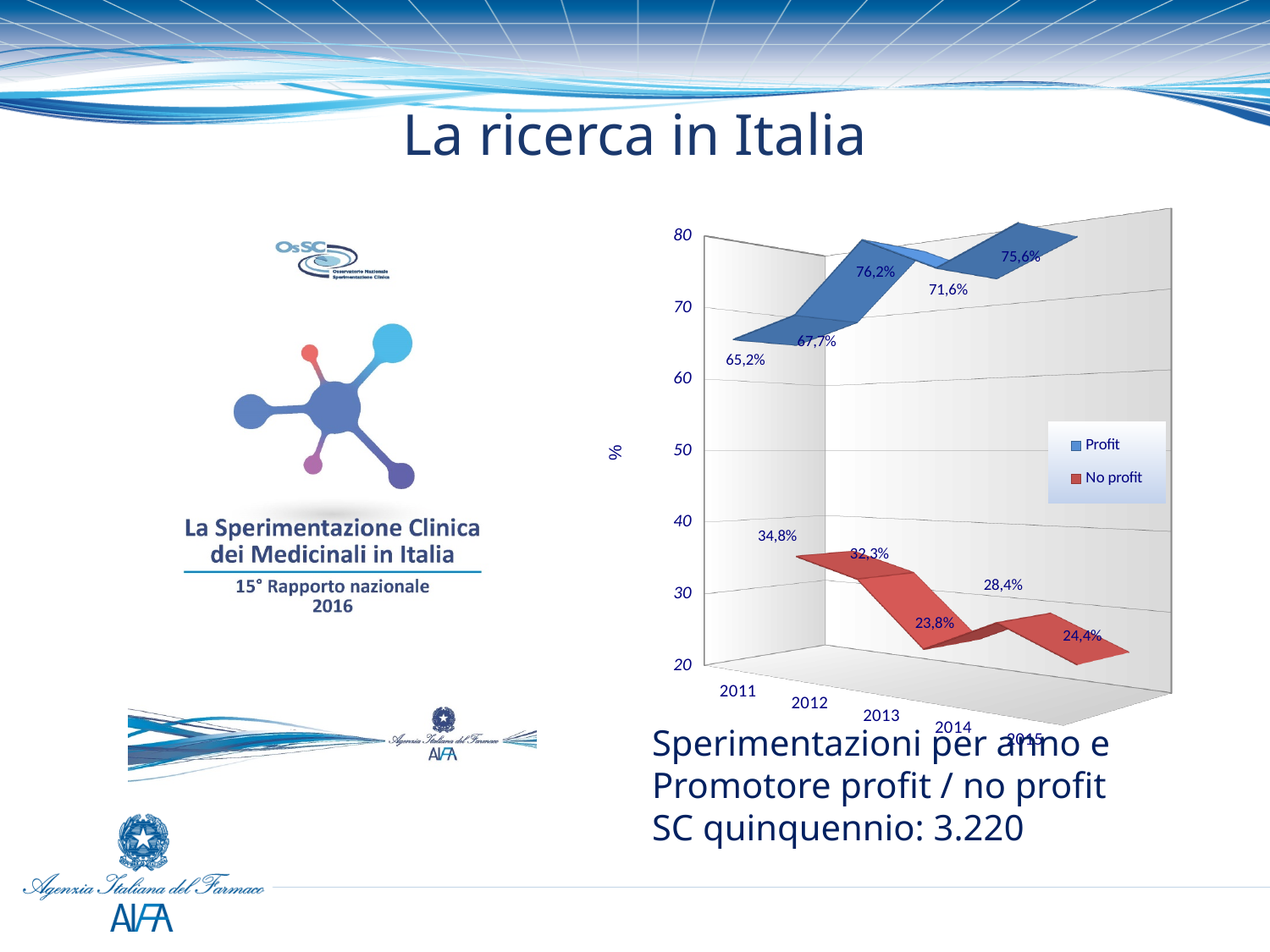
How many years are shown on the x axis? 5 In which year is the Profit series highest? 2013 What is the Profit value for 2011? 65,2% In which year is the No profit series lowest? 2013 What is the Profit value for 2015? 75,6% What is the No profit value for 2014? 28,4% What is the difference between the Profit and No profit values in 2011? 30,4% Which is larger, the Profit value for 2013 or the Profit value for 2014? 2013 Does the No profit series generally rise or fall from 2011 to 2015? fall What kind of chart is shown on the slide? line chart What is the No profit value for 2013? 23,8% How many series does the legend list? 2